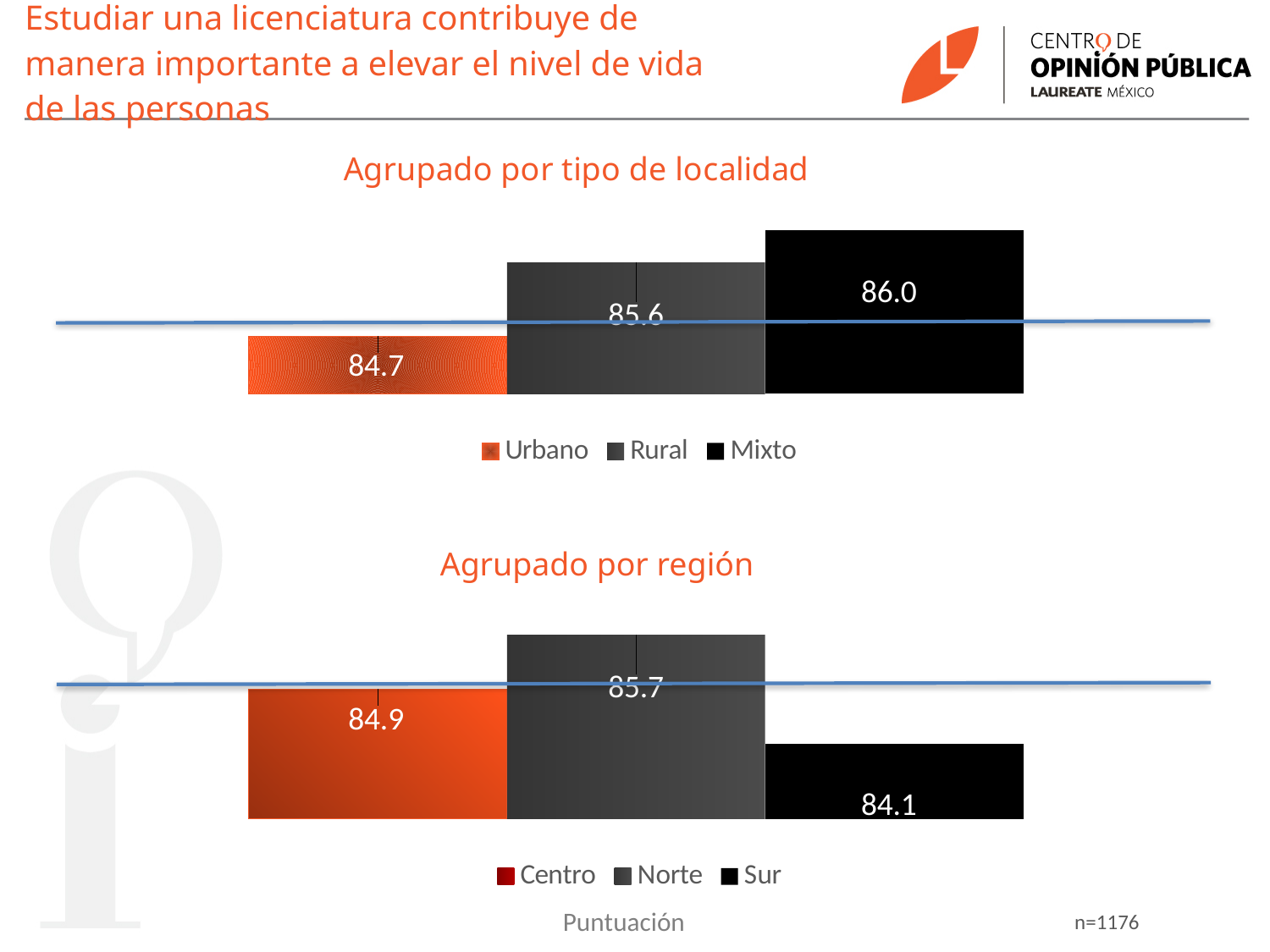
In the 'Agrupado por tipo de localidad' chart, what is the value for Urbano? 84.7 In the 'Agrupado por tipo de localidad' chart, what is the difference between the Mixto and Urbano values? 1.3 In the 'Agrupado por tipo de localidad' chart, which category has the highest value? Mixto In the 'Agrupado por región' chart, which is larger, Centro or Norte? Norte In the 'Agrupado por tipo de localidad' chart, which category has the lowest value? Urbano In the 'Agrupado por región' chart, what is the value for Sur? 84.1 In the 'Agrupado por región' chart, what is the value for Norte? 85.7 In the 'Agrupado por tipo de localidad' chart, what is the value for Mixto? 86.0 In the 'Agrupado por tipo de localidad' chart, how many series does the legend list? 3 What kind of chart is the 'Agrupado por región' chart? Bar chart In the 'Agrupado por región' chart, which category has the lowest value? Sur In the 'Agrupado por región' chart, what is the difference between the Norte and Sur values? 1.6